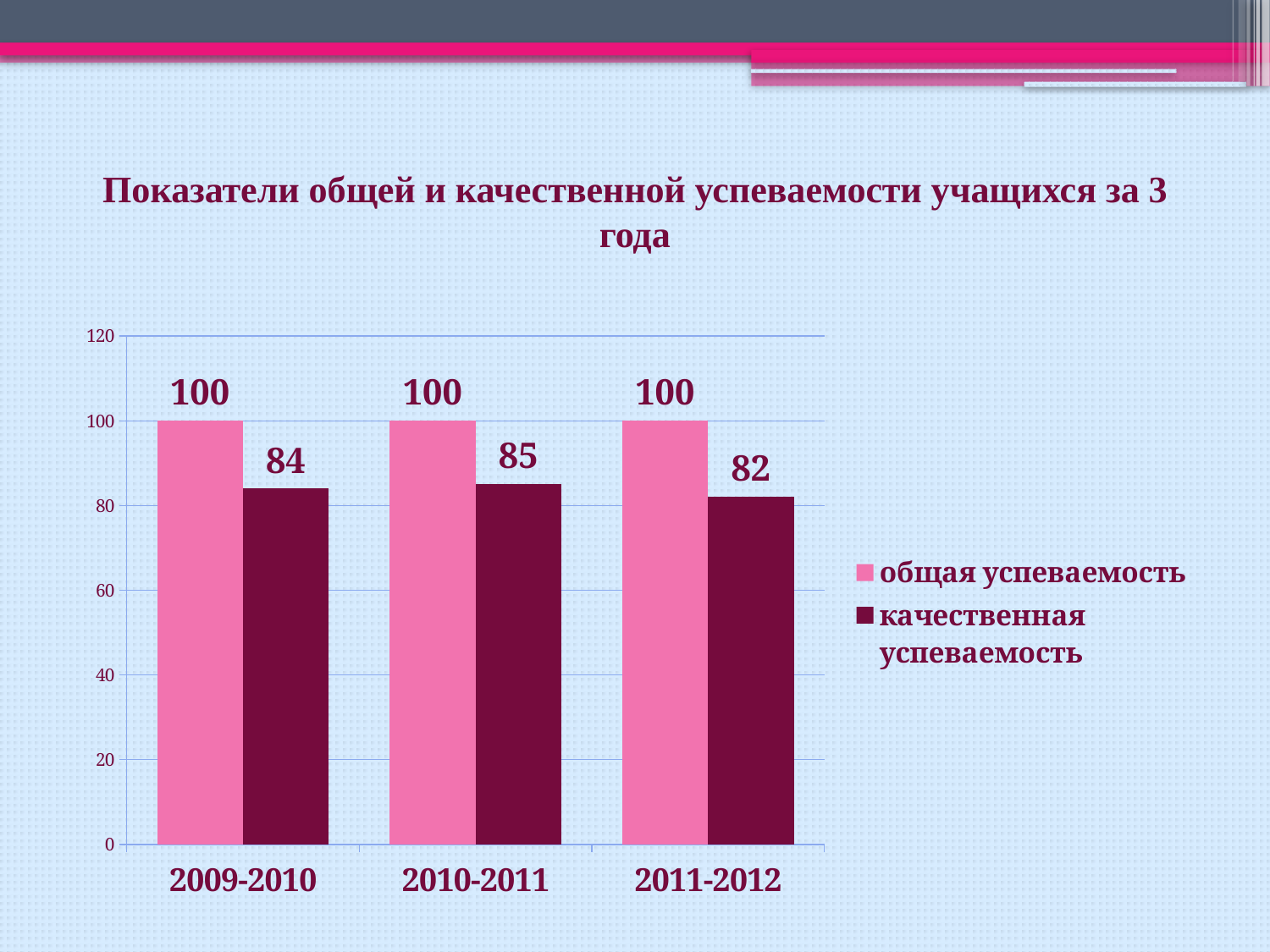
What is the difference between общая успеваемость and качественная успеваемость in 2011-2012? 18 In which year is качественная успеваемость the highest? 2010-2011 What is the value of качественная успеваемость for 2010-2011? 85 What is the value of качественная успеваемость for 2011-2012? 82 What kind of chart is shown on the slide? bar chart How many series does the legend list? 2 What is the value of общая успеваемость for 2011-2012? 100 What is the title of the slide? Показатели общей и качественной успеваемости учащихся за 3 года How many year categories are shown on the x axis? 3 Which is larger: качественная успеваемость in 2009-2010 or in 2011-2012? 2009-2010 In which year is качественная успеваемость the lowest? 2011-2012 What is the value of качественная успеваемость for 2009-2010? 84